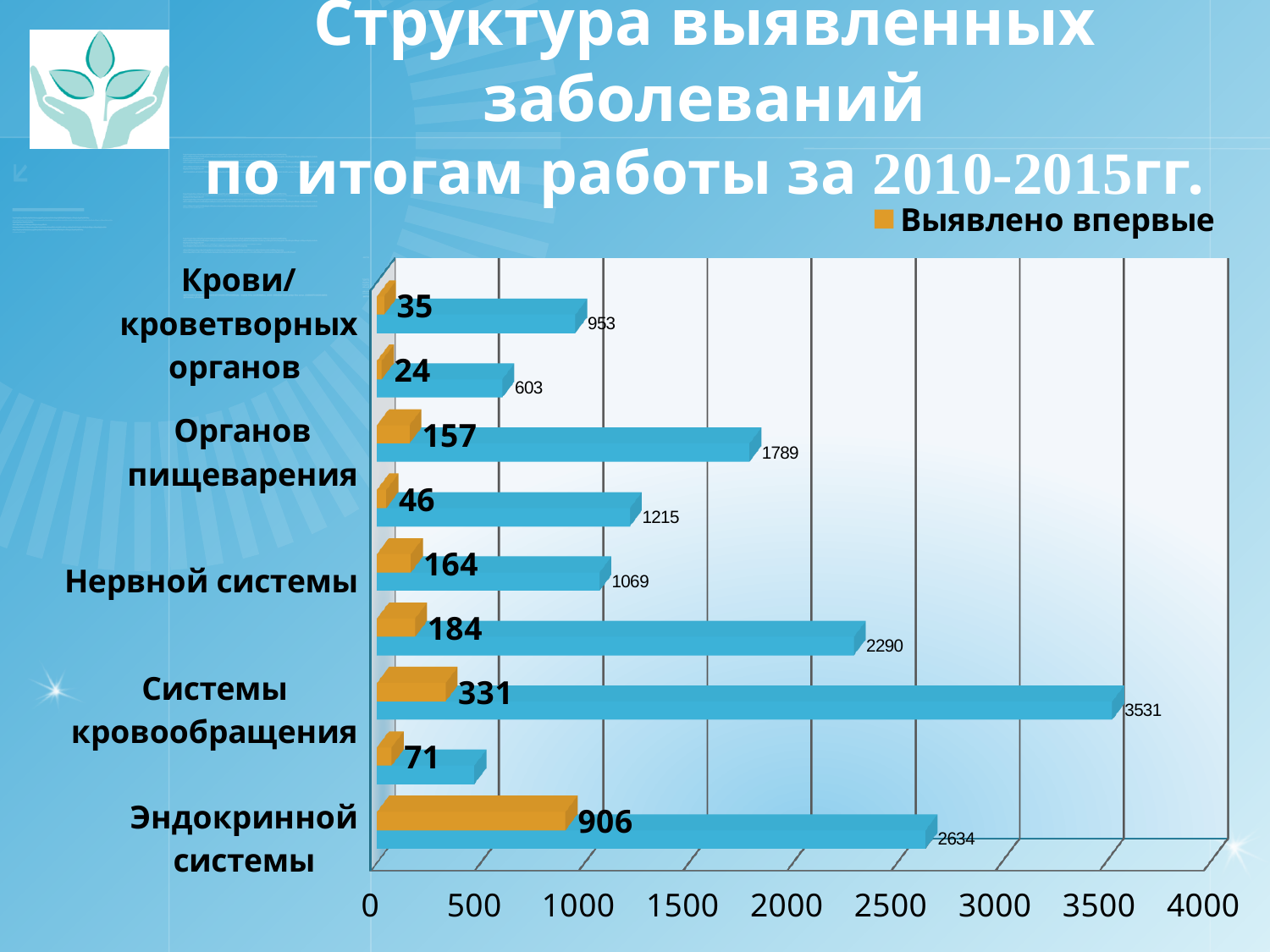
Which has the larger 'Выявлено впервые' value: Эндокринной системы or Нервной системы? Эндокринной системы What is the 'Выявлено впервые' (orange) value for Нервной системы? 164 What is the series name shown in the legend? Выявлено впервые What is the value of the blue bar for Эндокринной системы? 2634 What is the 'Выявлено впервые' (orange) value for Эндокринной системы? 906 What is the difference between the blue bar value and the orange bar value for Эндокринной системы? 1728 Which category has the highest 'Выявлено впервые' (orange) value? Эндокринной системы What is the largest value printed on any blue bar? 3531 How many pairs of bars (rows) are plotted in the chart? 9 How many series does the legend list? 1 What is the smallest value printed on any orange bar? 24 What kind of chart is shown on the slide? bar chart